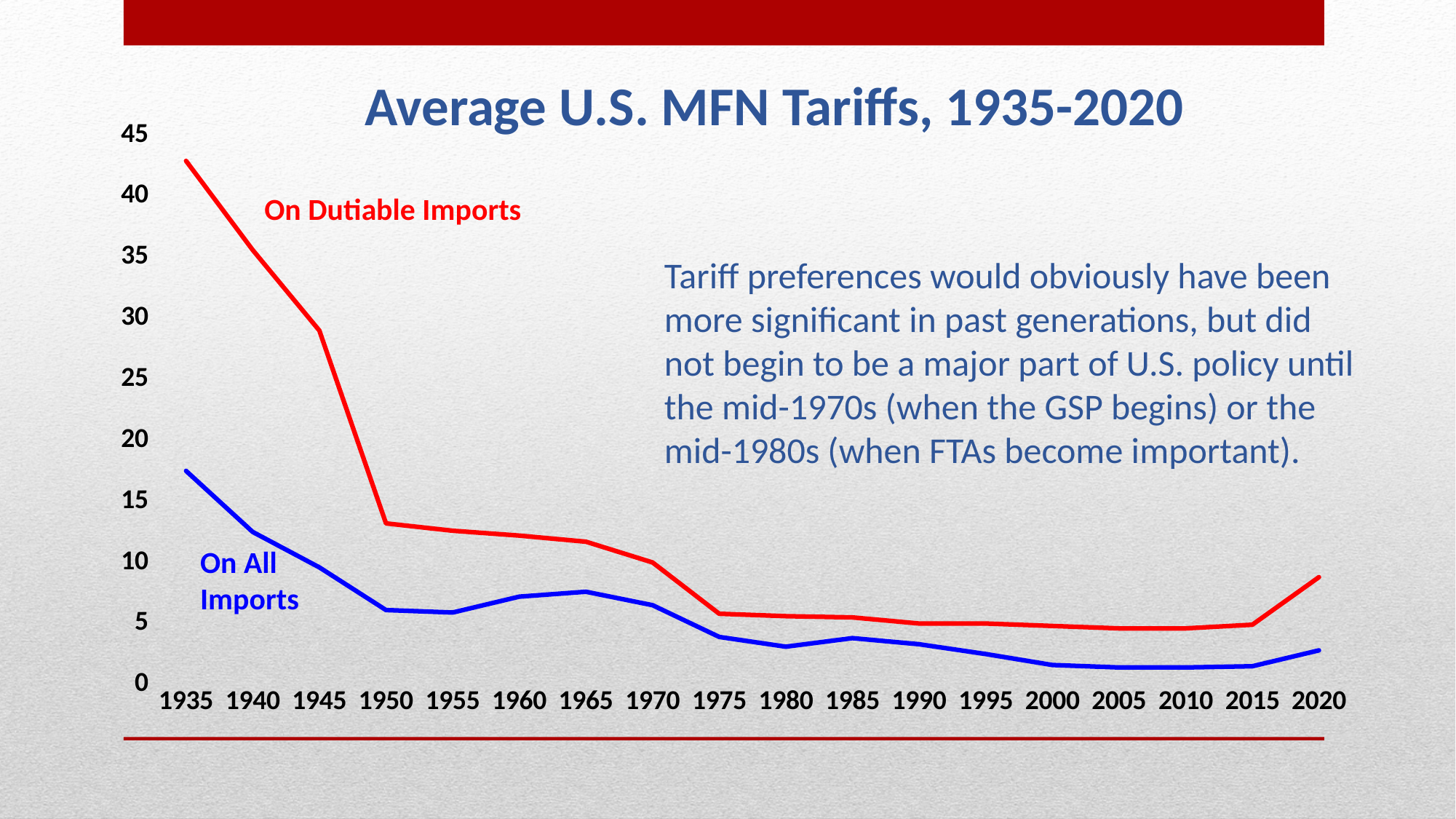
Does the On Dutiable Imports line rise or fall between 1935 and 1950? fall Is the value for On All Imports in 1935 greater or less than 15? greater What is the title of the chart? Average U.S. MFN Tariffs, 1935-2020 How many series are plotted on the chart? 2 What kind of chart is shown on the slide? line chart In which year is the On Dutiable Imports line at its highest? 1935 Is the value for On All Imports in 2020 greater or less than 5? less Is the value for On Dutiable Imports in 1950 greater or less than 10? greater How many years are labelled along the x axis of the chart? 18 In 1935, which series has the larger value, On Dutiable Imports or On All Imports? On Dutiable Imports